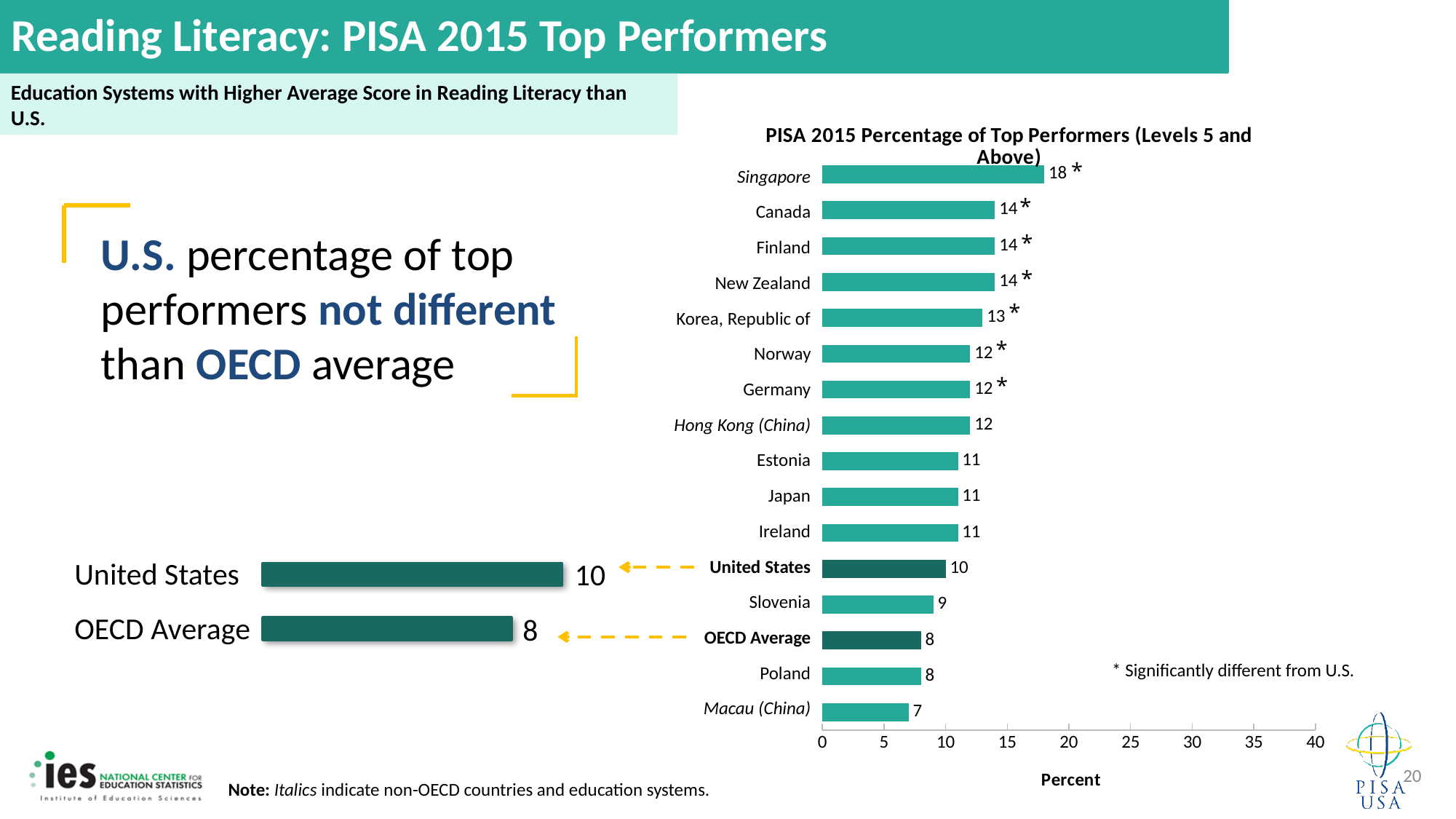
In the chart titled 'PISA 2015 Percentage of Top Performers (Levels 5 and Above)', what is the value for Singapore? 18 In the chart titled 'PISA 2015 Percentage of Top Performers (Levels 5 and Above)', what is the label on the horizontal axis? Percent In the chart titled 'PISA 2015 Percentage of Top Performers (Levels 5 and Above)', how many education systems (bars) are shown? 16 In the chart titled 'PISA 2015 Percentage of Top Performers (Levels 5 and Above)', what is the value for Slovenia? 9 In the small bar chart on the left of the slide, what is the value for OECD Average? 8 In the small bar chart on the left of the slide, what is the difference between the values for United States and OECD Average? 2 What kind of chart is the chart titled 'PISA 2015 Percentage of Top Performers (Levels 5 and Above)'? Bar chart In the chart titled 'PISA 2015 Percentage of Top Performers (Levels 5 and Above)', what is the difference between the values for Singapore and the United States? 8 In the chart titled 'PISA 2015 Percentage of Top Performers (Levels 5 and Above)', which education system has the lowest value? Macau (China) In the chart titled 'PISA 2015 Percentage of Top Performers (Levels 5 and Above)', which education system has the highest value? Singapore In the chart titled 'PISA 2015 Percentage of Top Performers (Levels 5 and Above)', which is larger, the value for Canada or the value for Norway? Canada In the chart titled 'PISA 2015 Percentage of Top Performers (Levels 5 and Above)', what is the value for Korea, Republic of? 13